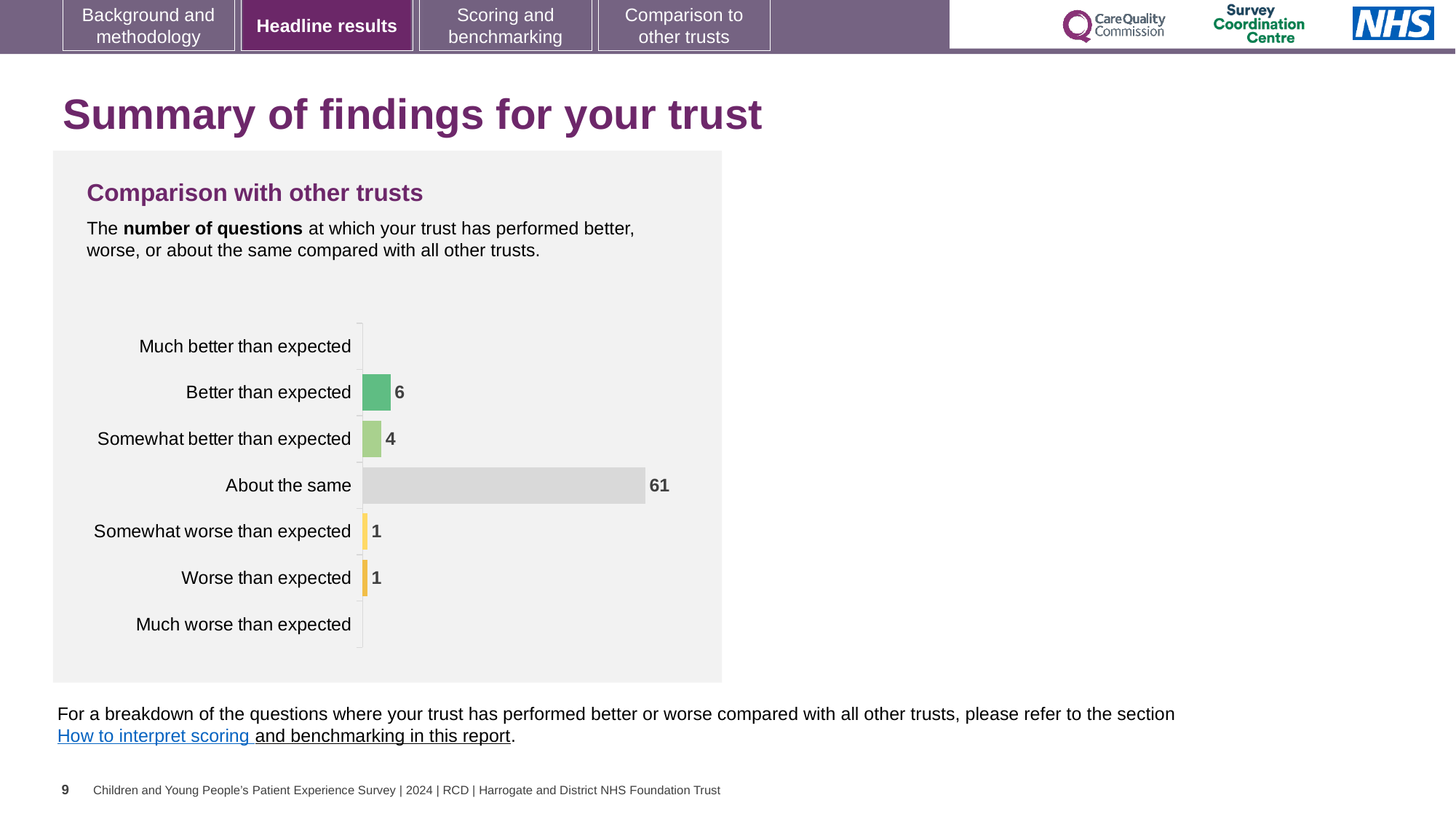
What is the title of the chart? Comparison with other trusts What is the value for 'Worse than expected'? 1 Which is larger, 'Better than expected' or 'Somewhat worse than expected'? Better than expected What is the value for 'Better than expected'? 6 What colour is the bar for 'About the same'? Grey Which category has the highest value? About the same What is the value for 'Somewhat better than expected'? 4 What is the value for 'About the same'? 61 What kind of chart is shown? Bar chart What is the difference between 'About the same' and 'Better than expected'? 55 What is the difference between 'Better than expected' and 'Somewhat better than expected'? 2 How many categories are listed on the chart's axis? 7